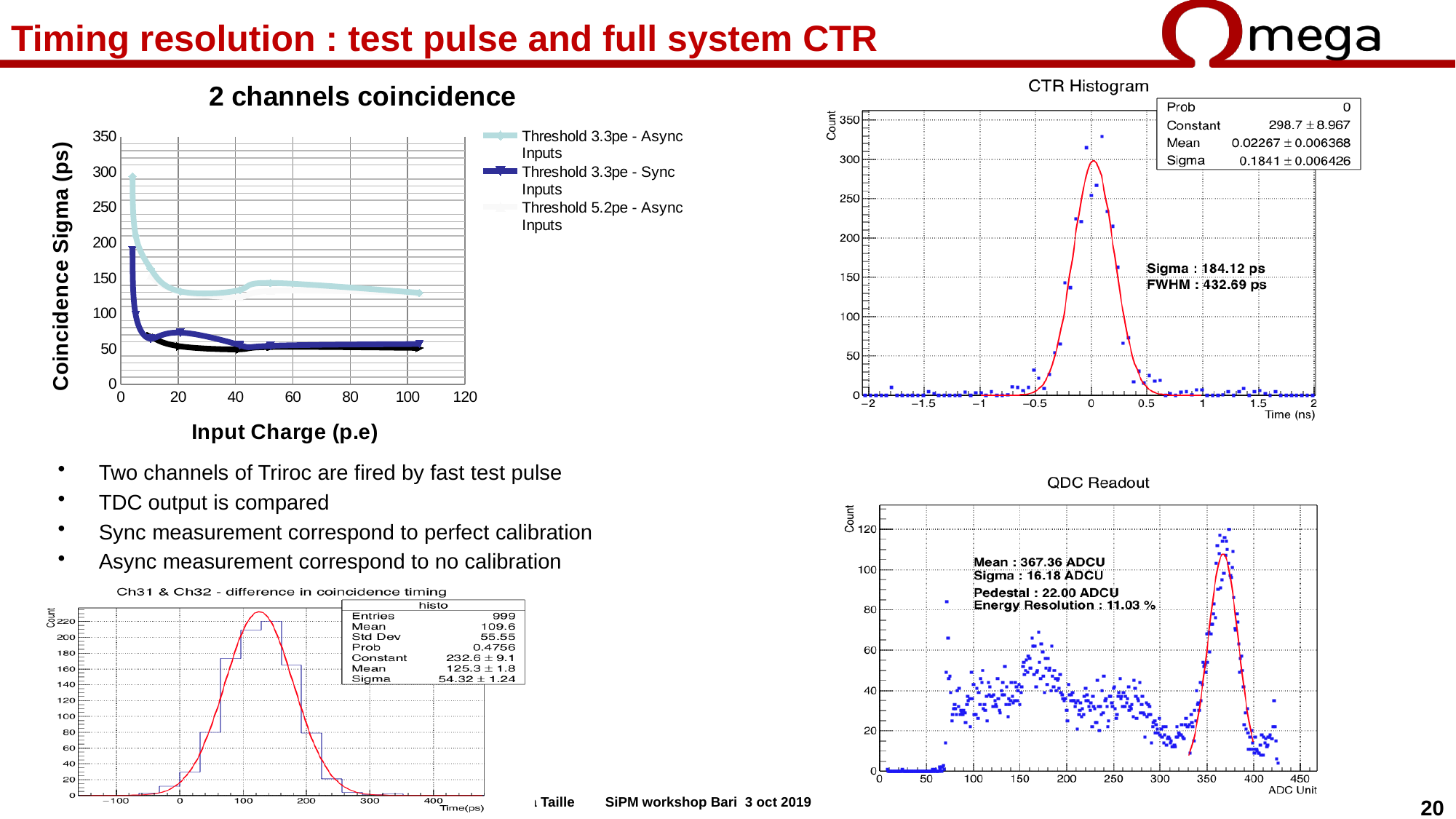
In the 'Ch31 & Ch32 - difference in coincidence timing' chart, how many entries does the statistics box report? 999 In the 'CTR Histogram' chart, what FWHM value is printed on the plot? 432.69 ps In the 'CTR Histogram' chart, what Sigma value in ps is printed on the plot? 184.12 ps In the 'QDC Readout' chart, what Energy Resolution is printed on the plot? 11.03 % In the '2 channels coincidence' chart, what is the label of the y axis? Coincidence Sigma (ps) In the '2 channels coincidence' chart, is the value for 'Threshold 3.3pe - Async Inputs' at an input charge of about 100 p.e greater or less than 150? less In the 'CTR Histogram' chart, what is the fitted Constant shown in the statistics box? 298.7 ± 8.967 In the '2 channels coincidence' chart, is the value for 'Threshold 3.3pe - Sync Inputs' at an input charge of about 100 p.e greater or less than 100? less In the '2 channels coincidence' chart, how many series does the legend list? 3 In the '2 channels coincidence' chart, do the coincidence sigma values rise or fall as input charge increases? fall What kind of chart is the '2 channels coincidence' chart? line chart In the '2 channels coincidence' chart, at an input charge of about 100 p.e, which series is higher: 'Threshold 3.3pe - Async Inputs' or 'Threshold 3.3pe - Sync Inputs'? Threshold 3.3pe - Async Inputs